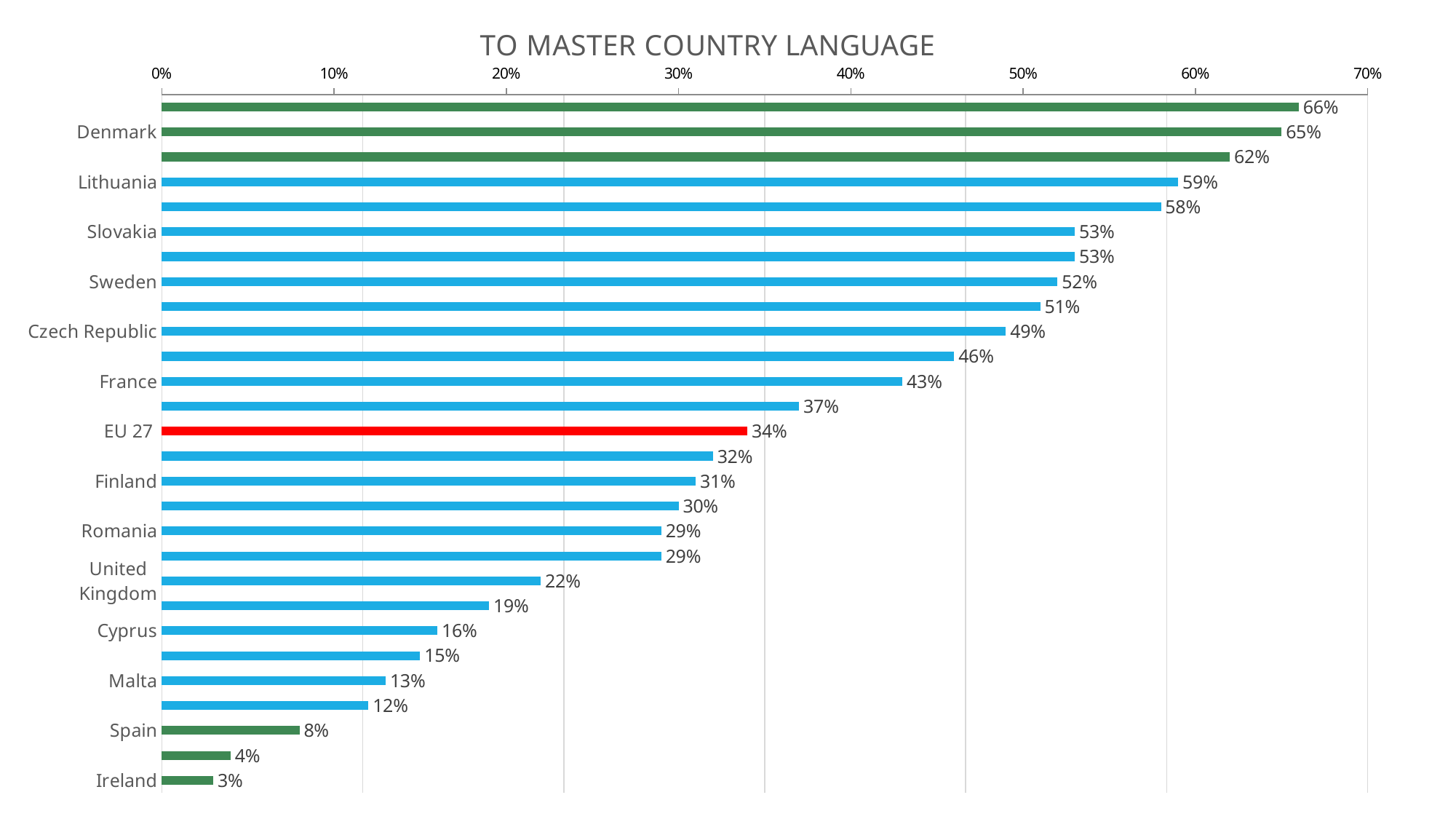
What is the value for Denmark? 65% What kind of chart is shown on the slide? bar chart What is the difference between the values for France and EU 27? 9% What is the difference between the values for Denmark and Spain? 57% What is the value for Ireland? 3% Is the value for Finland greater or less than 40%? less What is the value for United Kingdom? 22% Which is larger, the value for Lithuania or the value for Sweden? Lithuania What is the title of the chart? TO MASTER COUNTRY LANGUAGE What is the value for EU 27? 34% Which category has the lowest value? Ireland What is the value for Czech Republic? 49%